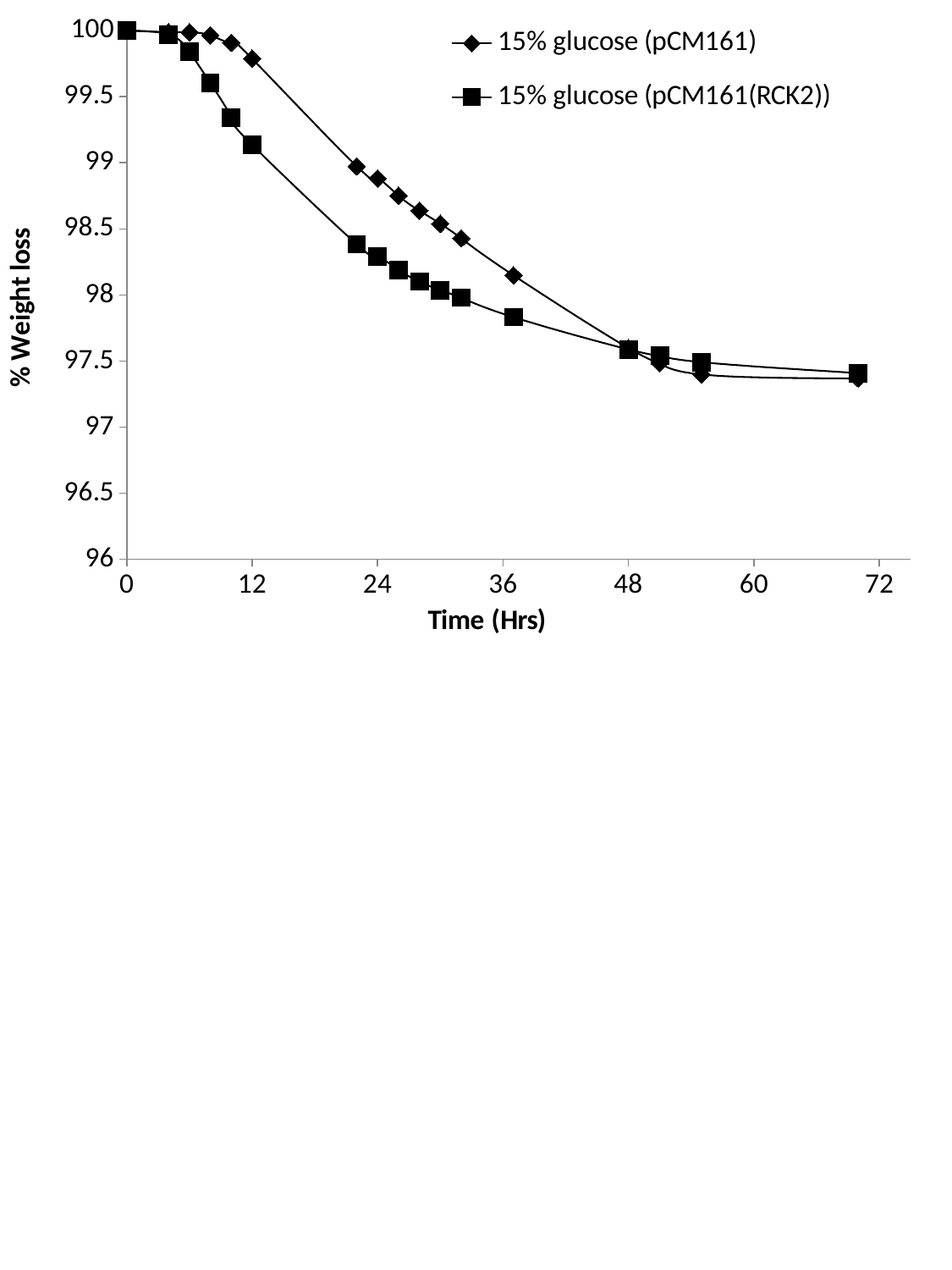
Is the value for 15% glucose (pCM161) at 12 hours greater or less than 99.5? greater What kind of chart is shown on the slide? line chart What is the label of the y axis? % Weight loss At 24 hours, which series has the higher value, 15% glucose (pCM161) or 15% glucose (pCM161(RCK2))? 15% glucose (pCM161) Is the value for 15% glucose (pCM161(RCK2)) at 24 hours greater or less than 98.5? less How many series does the legend list? 2 Is the value for 15% glucose (pCM161) at 24 hours greater or less than 98.5? greater What is the label of the x axis? Time (Hrs) Do the values for the 15% glucose (pCM161) series rise or fall as time increases? fall What is the value of both series at 0 hours? 100 Do the values for the 15% glucose (pCM161(RCK2)) series rise or fall as time increases? fall